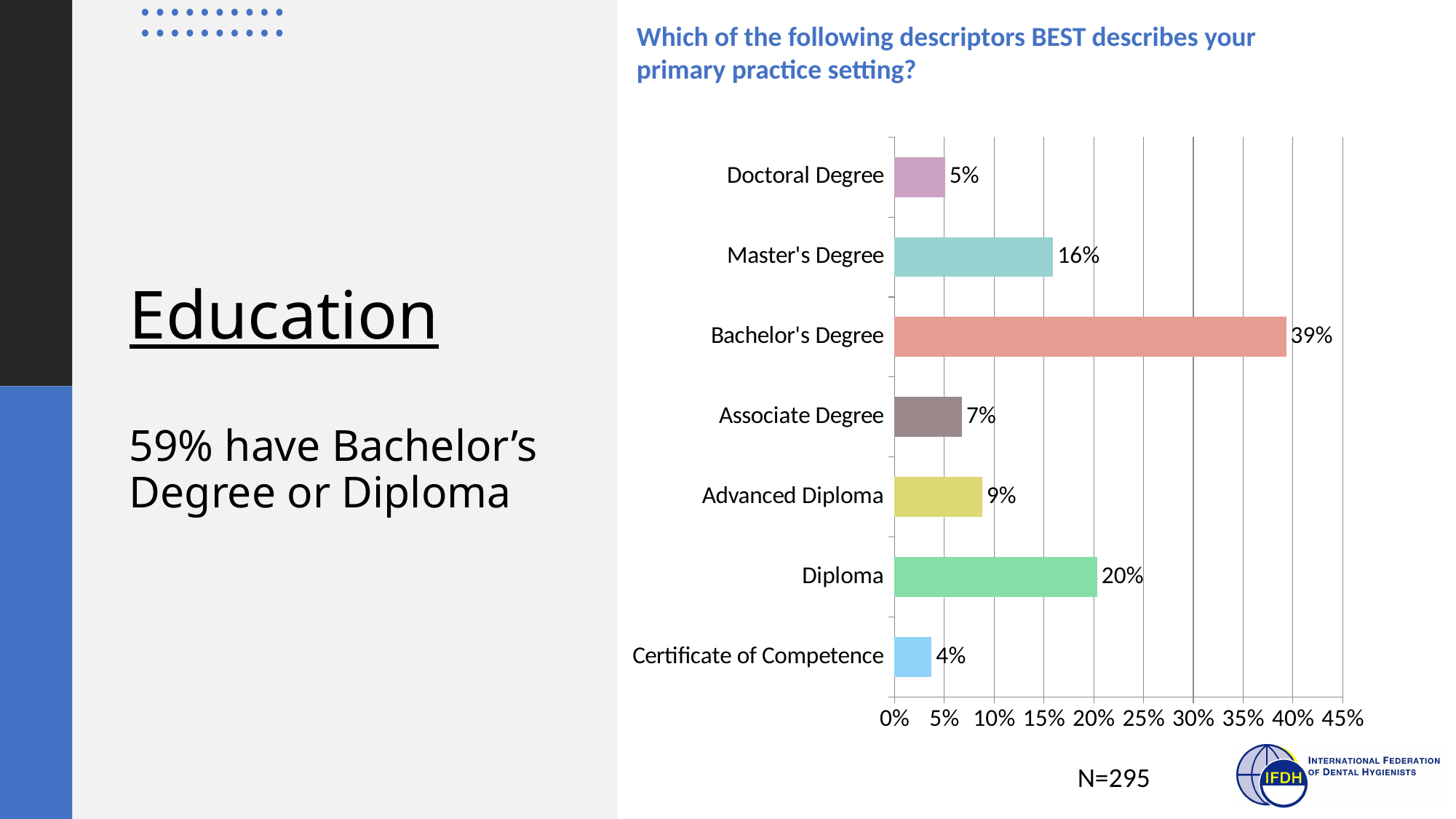
What is the difference between the Bachelor's Degree and Diploma values? 19% What percentage is shown for Certificate of Competence? 4% Which category has the highest value? Bachelor's Degree What percentage of respondents have a Bachelor's Degree? 39% Which category has the lowest value? Certificate of Competence What is the value shown for Diploma? 20% What is the difference between the Master's Degree and Associate Degree values? 9% What is the value for Master's Degree? 16% What sample size (N) is shown below the chart? N=295 How many categories are shown in the chart? 7 Which is larger, Advanced Diploma or Doctoral Degree? Advanced Diploma What kind of chart is shown on the slide? Bar chart